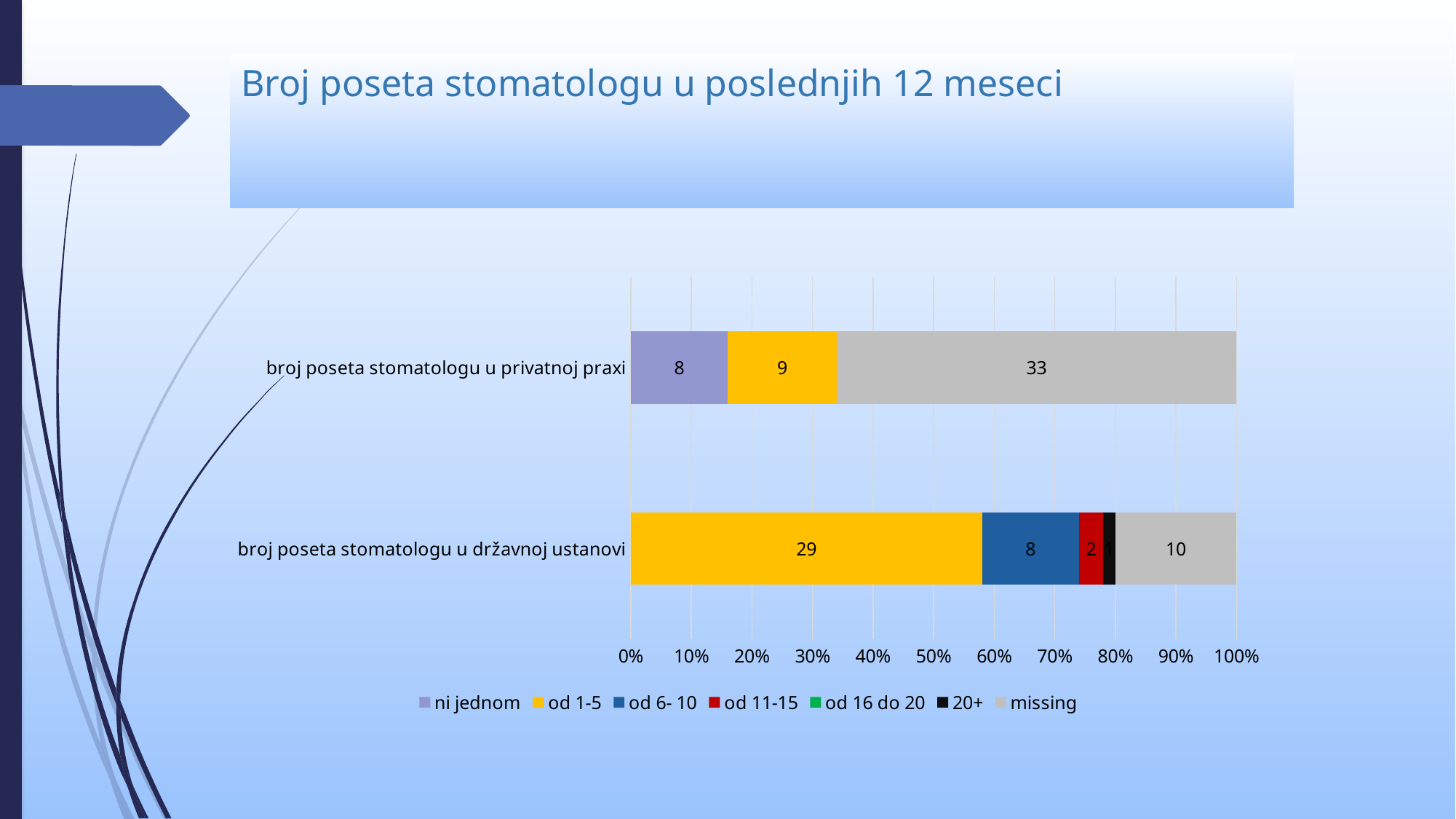
What is the value of the "missing" segment for "broj poseta stomatologu u privatnoj praxi"? 33 What is the value of the "ni jednom" segment for "broj poseta stomatologu u privatnoj praxi"? 8 What is the value of the "od 1-5" segment for "broj poseta stomatologu u državnoj ustanovi"? 29 What is the title of the slide? Broj poseta stomatologu u poslednjih 12 meseci What is the difference between the "missing" values for "broj poseta stomatologu u privatnoj praxi" and "broj poseta stomatologu u državnoj ustanovi"? 23 What is the value of the "od 6- 10" segment for "broj poseta stomatologu u državnoj ustanovi"? 8 What is the value of the "od 11-15" segment for "broj poseta stomatologu u državnoj ustanovi"? 2 What kind of chart is shown on the slide? Stacked bar chart What is the total of the labelled segments in the bar for "broj poseta stomatologu u privatnoj praxi"? 50 Which category has the larger "od 1-5" value, "broj poseta stomatologu u privatnoj praxi" or "broj poseta stomatologu u državnoj ustanovi"? broj poseta stomatologu u državnoj ustanovi How many categories (bars) are shown in the chart? 2 How many series does the legend list? 7